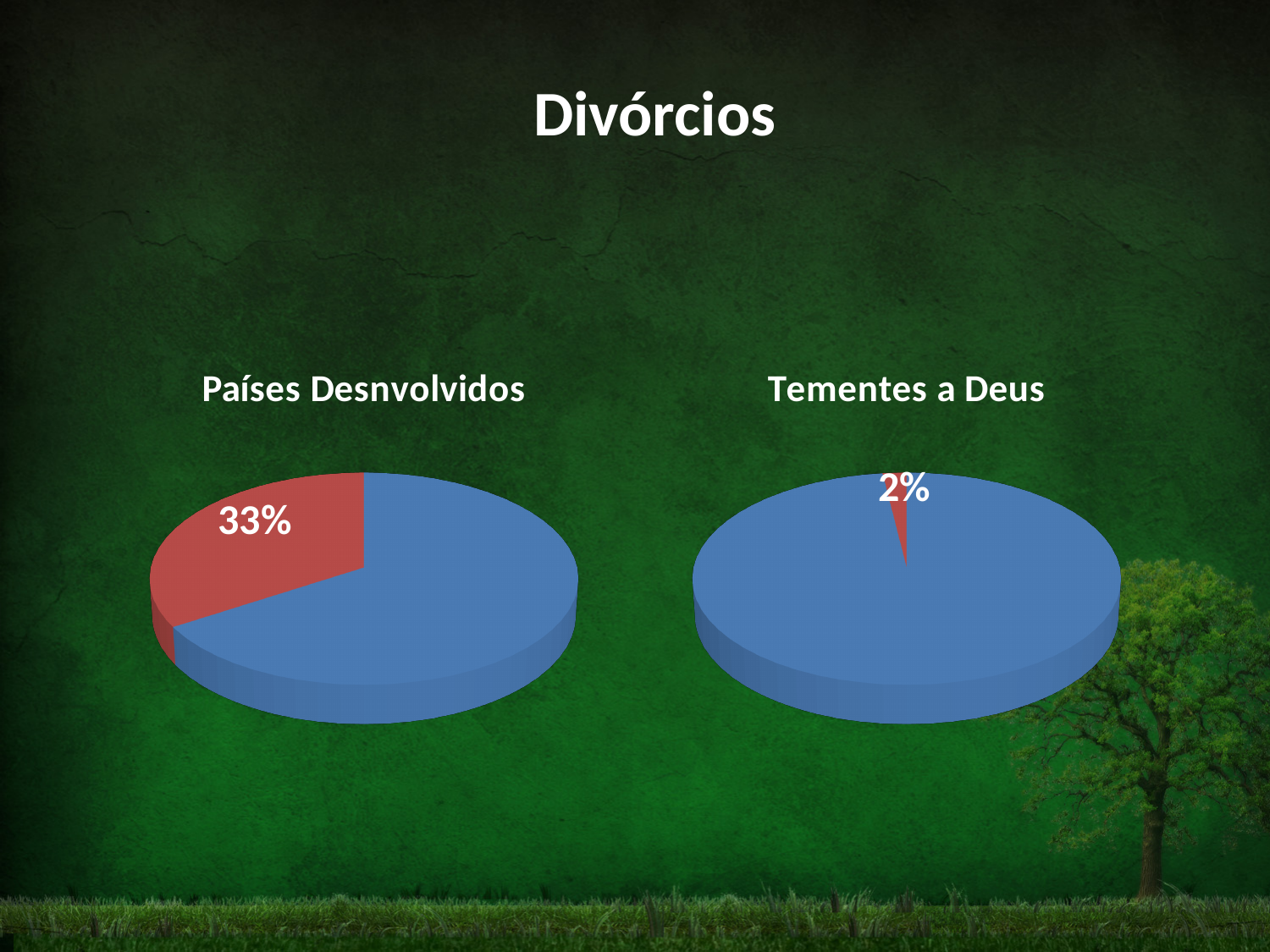
What is the title at the top of the slide above the two charts? Divórcios In the "Tementes a Deus" chart, what percentage is shown on the red slice? 2% In the "Tementes a Deus" chart, is the labelled slice greater or less than 10%? less How many slices does the "Países Desnvolvidos" pie chart have? 2 What colour is the larger slice in the "Tementes a Deus" chart? blue How many pie charts are shown on the slide? 2 In the "Países Desnvolvidos" chart, is the labelled slice greater or less than 50%? less What is the difference in percentage points between the labelled slice in the "Países Desnvolvidos" chart and the labelled slice in the "Tementes a Deus" chart? 31 What kind of chart is the "Países Desnvolvidos" chart? pie chart How many slices does the "Tementes a Deus" pie chart have? 2 Which chart has the larger labelled red slice, "Países Desnvolvidos" or "Tementes a Deus"? Países Desnvolvidos In the "Países Desnvolvidos" chart, what percentage is shown on the red slice? 33%